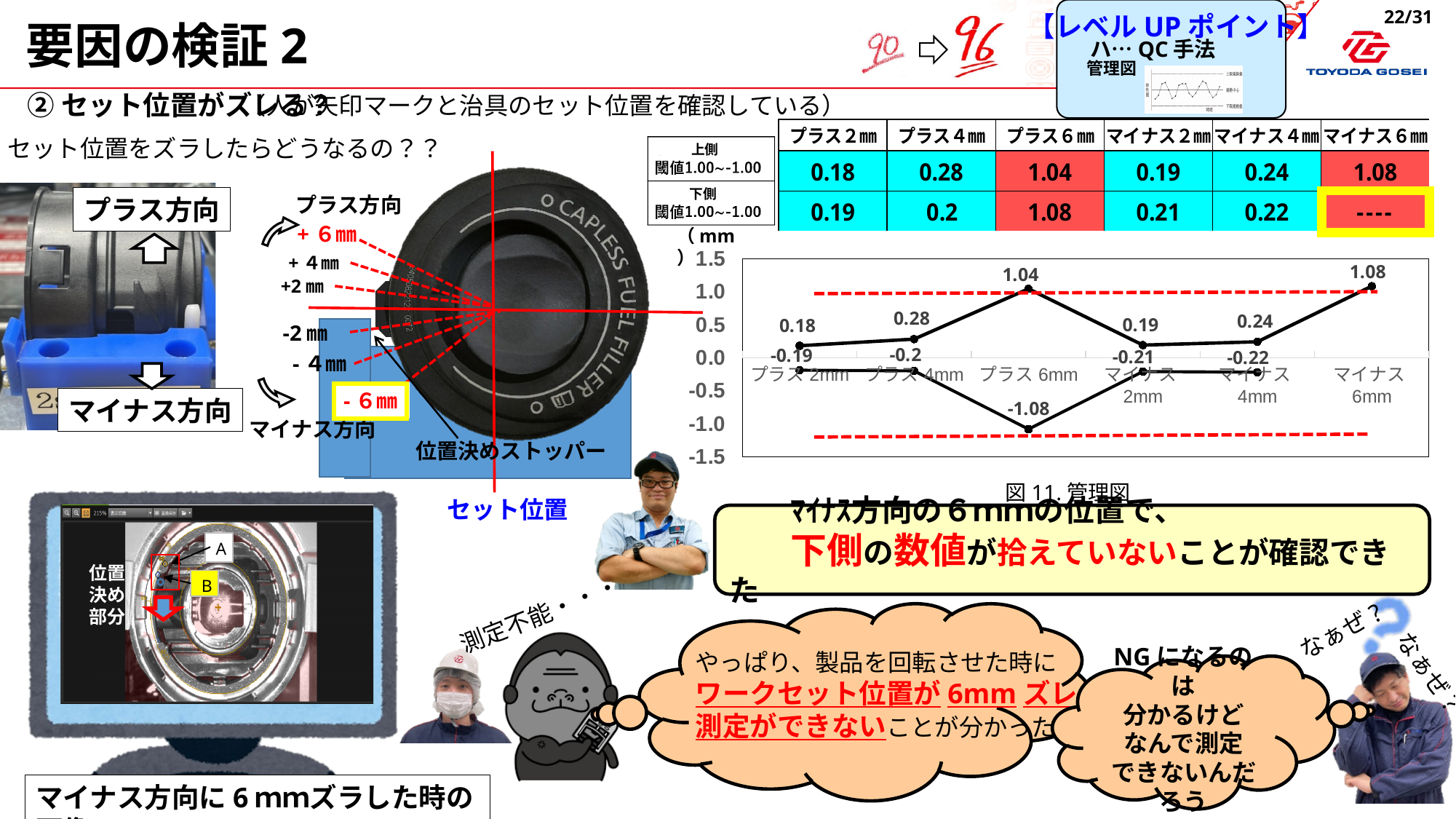
Which category has the lowest upper-side (上側) value in the chart? プラス2mm What kind of chart is shown on the slide (図11 管理図)? line chart What is the upper-side (上側) value plotted for プラス2mm? 0.18 What is the lower-side (下側) value plotted for マイナス4mm? -0.22 What is the upper-side (上側) value plotted for マイナス6mm? 1.08 What unit is shown on the y axis of the chart? mm What is the lower-side (下側) value plotted for プラス6mm? -1.08 What is the upper-side (上側) value plotted for プラス6mm? 1.04 What is the difference between the upper-side values for マイナス6mm and プラス6mm? 0.04 Which category has the highest upper-side (上側) value in the chart? マイナス6mm How many categories are shown on the x axis of the chart? 6 Which is larger, the upper-side value for プラス4mm or for マイナス4mm? プラス4mm